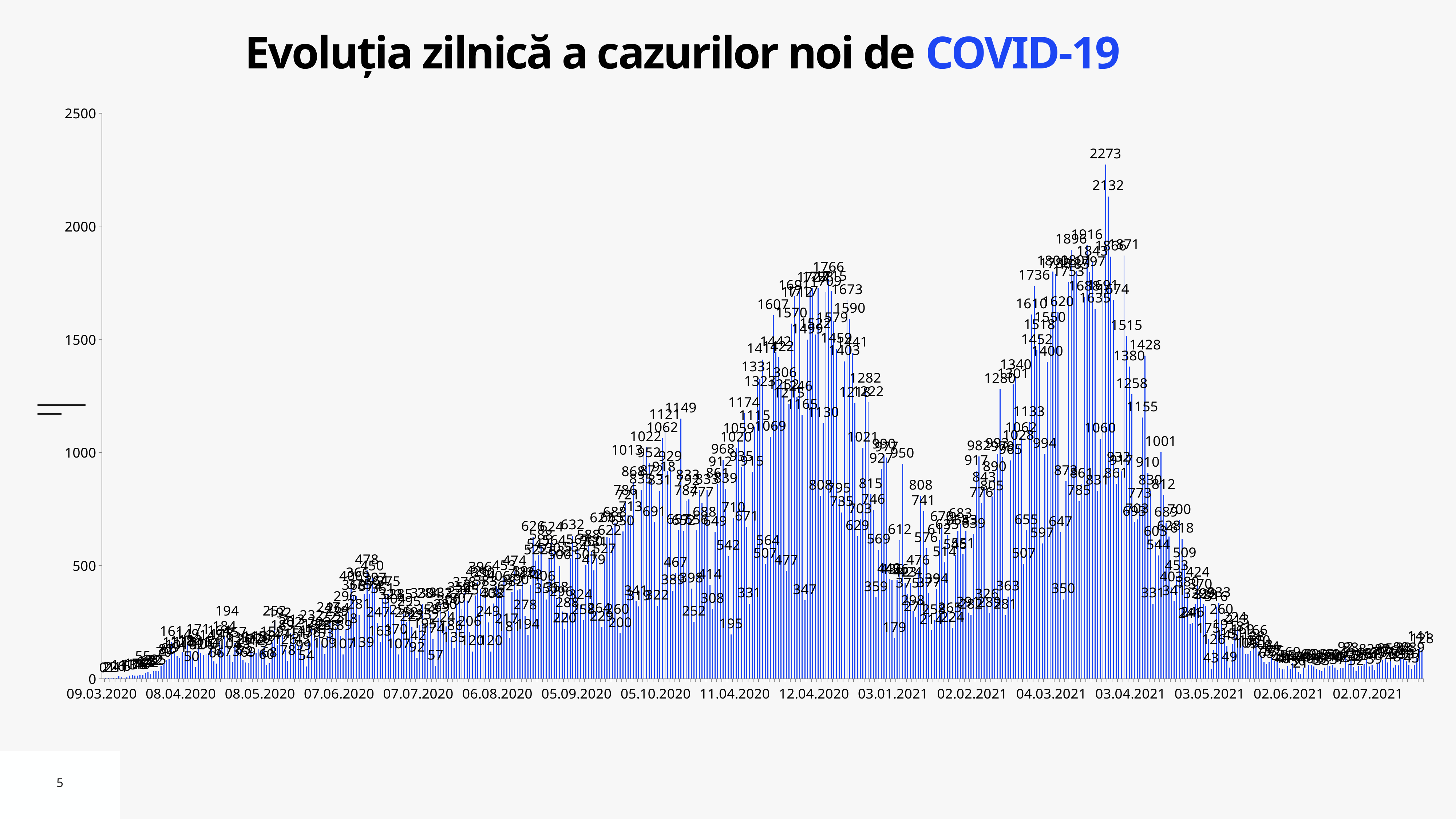
What is the difference between the two highest labelled values, 2273 and 2132? 141 Is the tallest bar in the chart greater or less than 2000? greater What is the second-highest data label shown in the chart, next to the 2273 peak? 2132 Which is larger, the peak value of 2273 or the earlier peak value of 1766? 2273 What kind of chart is shown on the slide? bar chart Do the values rise or fall between 03.04.2021 and 02.06.2021? fall What is the highest tick value on the vertical axis? 2500 What is the highest daily value shown in the chart? 2273 What is the last date label on the horizontal axis? 02.07.2021 Are the bars around 02.06.2021 greater or less than 500? less What is the first date label on the horizontal axis? 09.03.2020 What is the title of the chart? Evoluția zilnică a cazurilor noi de COVID-19